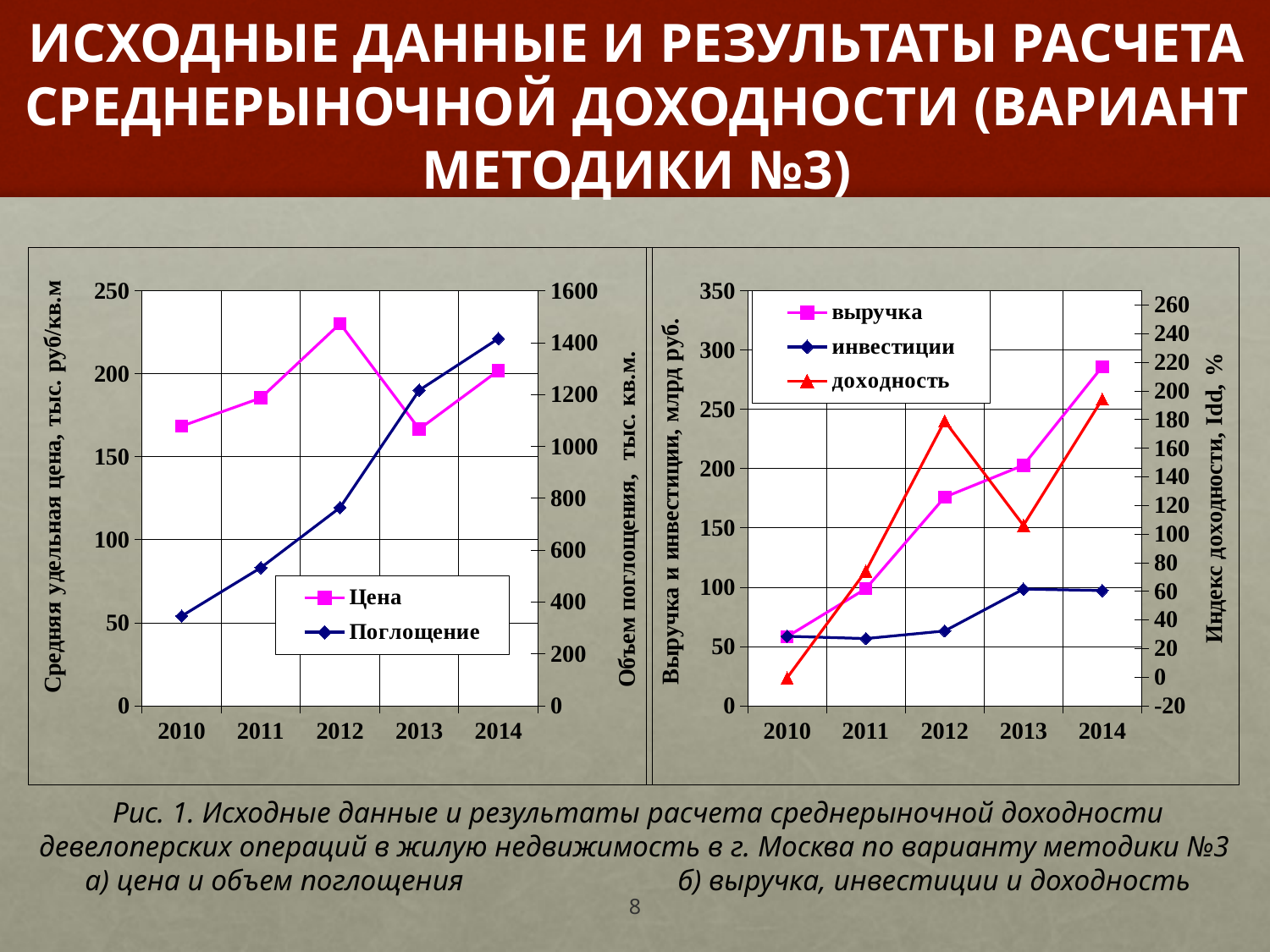
In the right chart (б) выручка, инвестиции и доходность), is the value of выручка in 2014 greater or less than 250? greater In the right chart (б) выручка, инвестиции и доходность), in which year is доходность lowest? 2010 What kind of chart is the left chart (а) цена и объем поглощения)? line chart In the left chart (а) цена и объем поглощения), does Поглощение rise or fall from 2010 to 2014? rise In the left chart (а) цена и объем поглощения), is the value of Поглощение in 2010 greater or less than 400? less In the right chart (б) выручка, инвестиции и доходность), in which year is выручка highest? 2014 In the left chart (а) цена и объем поглощения), in which year is Цена highest? 2012 In the right chart (б) выручка, инвестиции и доходность), which series is drawn with red triangle markers? доходность In the left chart (а) цена и объем поглощения), is the value of Цена in 2012 greater or less than 200? greater How many years are shown on the x axis of the left chart (а) цена и объем поглощения)? 5 How many series does the legend of the right chart (б) выручка, инвестиции и доходность) list? 3 In the left chart (а) цена и объем поглощения), in which year is Поглощение lowest? 2010